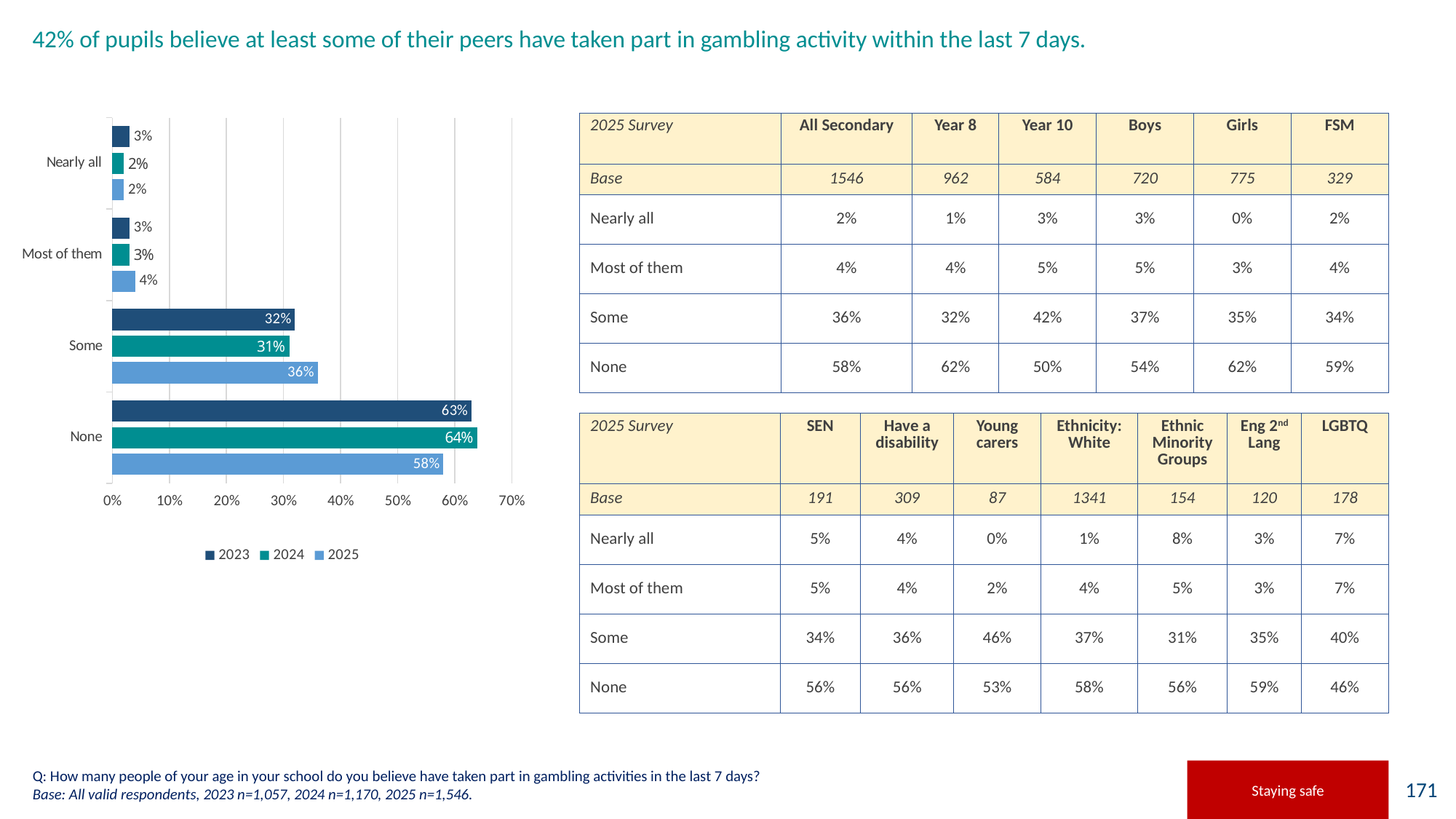
How many series does the legend list? 3 What is the value for Nearly all in 2023? 3% What is the difference between the 2024 and 2025 values for None? 6% What is the value for None in 2025? 58% Is the value for None in 2023 greater or less than 50%? greater Which is larger for Some: the 2023 value or the 2025 value? 2025 What is the value for Most of them in 2025? 4% Which category has the highest value in 2024? None Which category has the lowest value in 2025? Nearly all What kind of chart is shown on the slide? Bar chart What is the value for Some in 2024? 31% How many categories are shown on the chart? 4